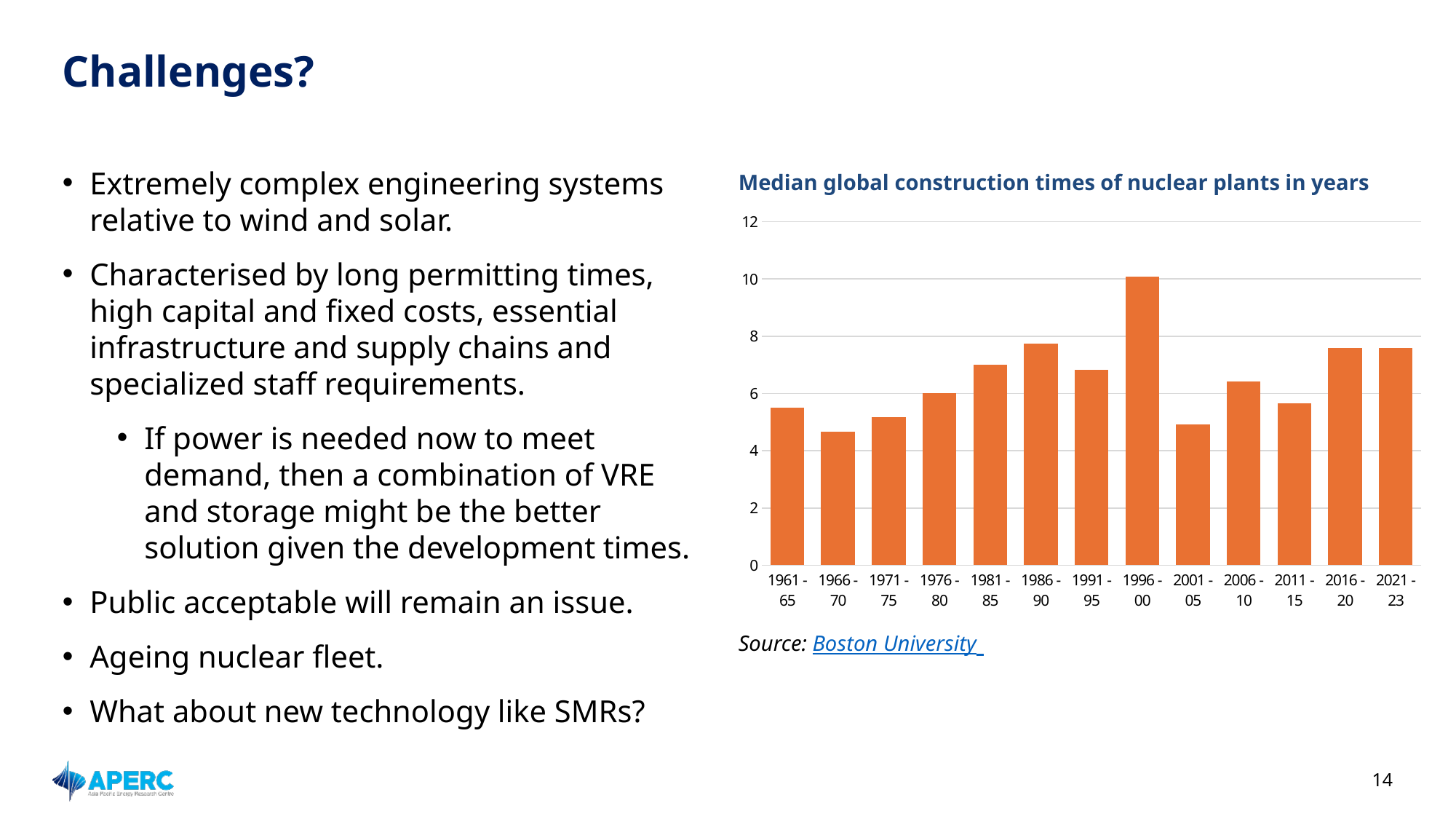
Is the value for 1996 - 00 greater or less than 8? greater Is the value for 1966 - 70 greater or less than 6? less Is the value for 1981 - 85 greater or less than 8? less What is the title of the chart? Median global construction times of nuclear plants in years What kind of chart is shown on the slide? bar chart Which is larger, the value for 1996 - 00 or the value for 2001 - 05? 1996 - 00 What source is cited for the chart? Boston University Which is larger, the value for 1986 - 90 or the value for 1966 - 70? 1986 - 90 How many time periods are shown on the x axis of the chart? 13 Which period has the highest median construction time? 1996 - 00